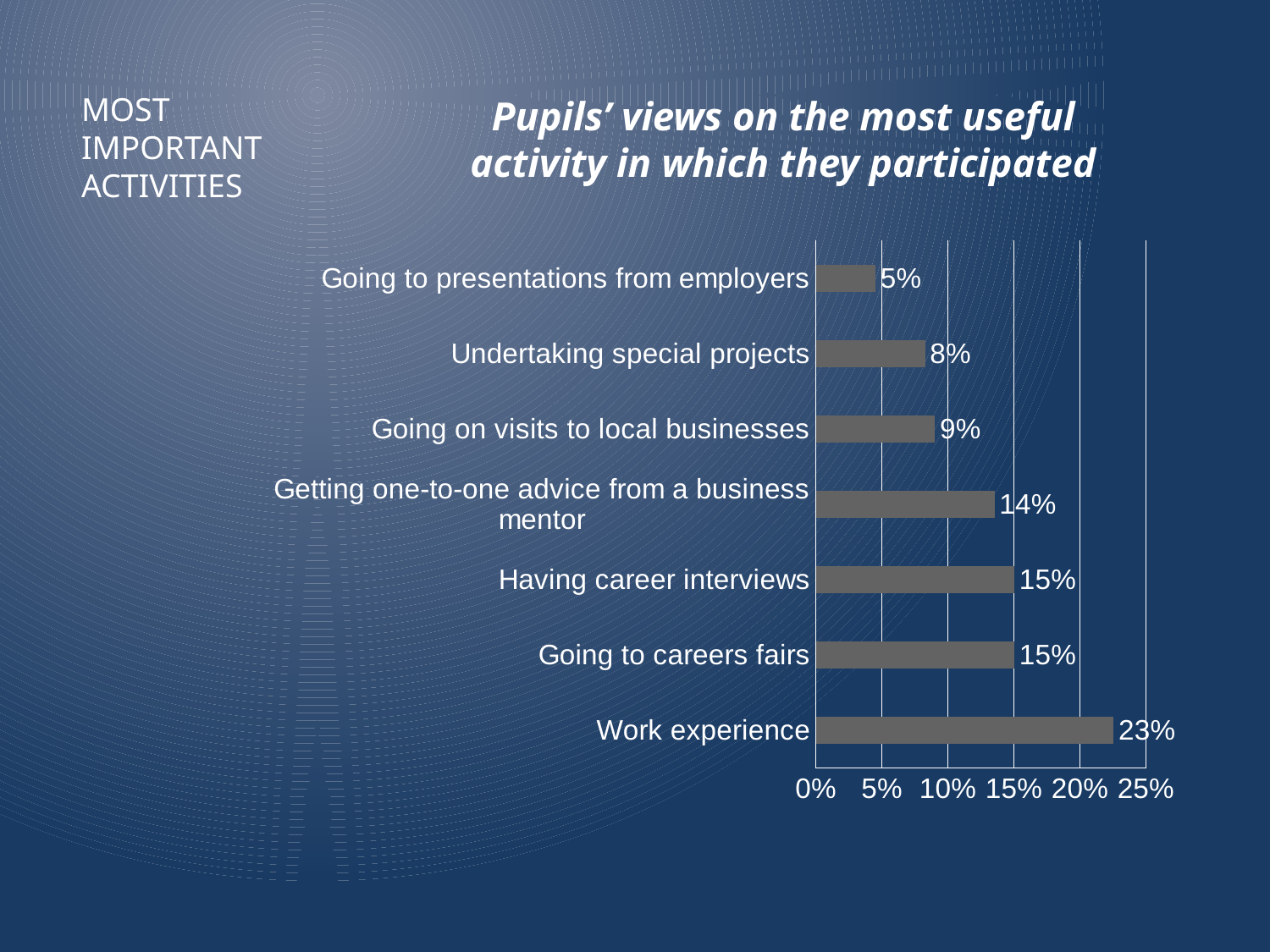
Which activity has the highest value? Work experience What is the value for 'Getting one-to-one advice from a business mentor'? 14% What type of chart is shown on the slide? Bar chart What percentage of pupils chose work experience as the most useful activity? 23% What is the difference between the values for 'Work experience' and 'Having career interviews'? 8% Which is larger: the value for 'Going on visits to local businesses' or 'Undertaking special projects'? Going on visits to local businesses What is the difference between 'Undertaking special projects' and 'Going to presentations from employers'? 3% How many activities are shown in the chart? 7 Which activity has the lowest value? Going to presentations from employers Is the value for 'Work experience' greater or less than 20%? greater What is the title of the chart? Pupils' views on the most useful activity in which they participated What is the value for 'Going on visits to local businesses'? 9%